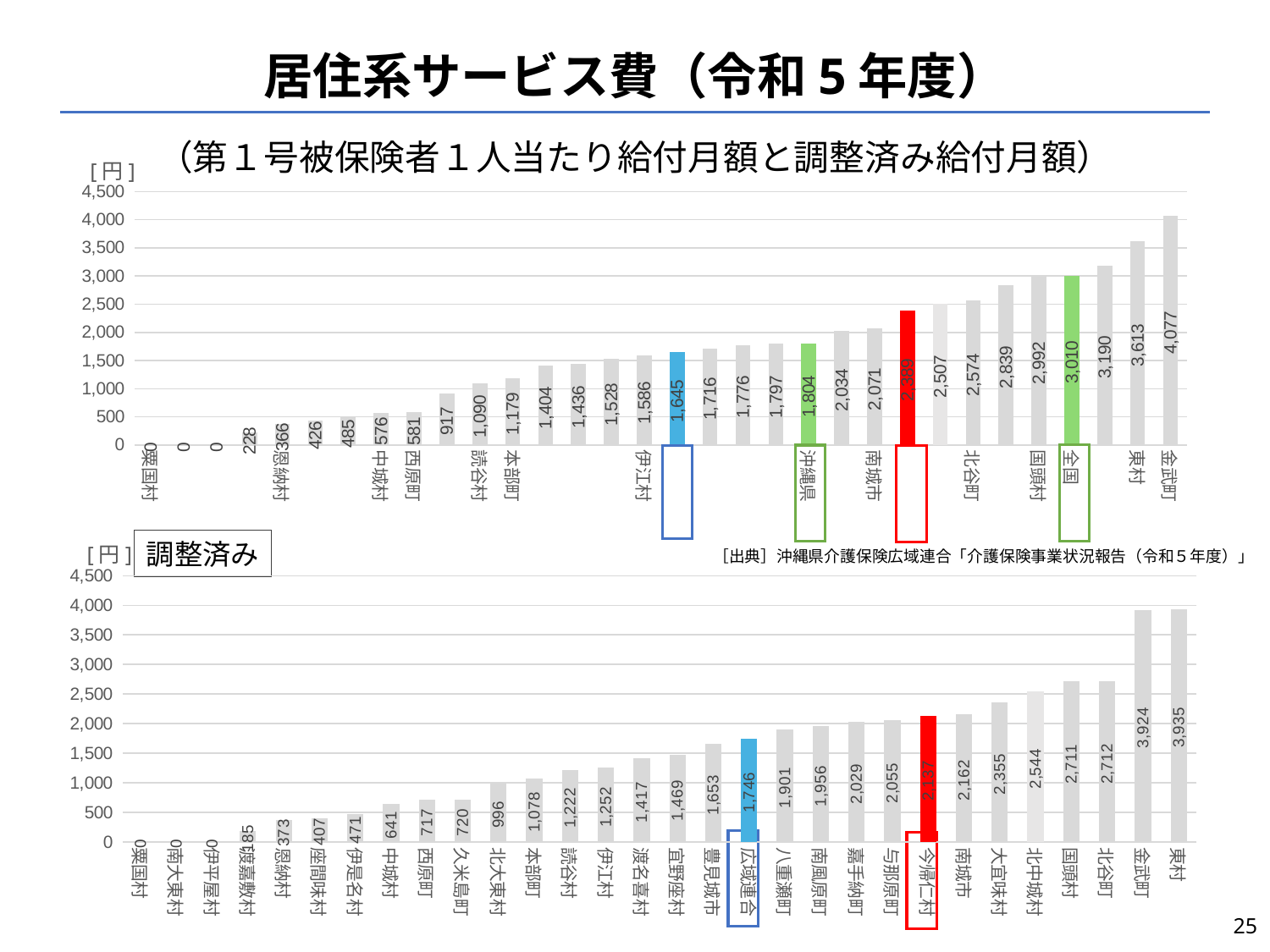
In the top chart, which category has the highest value? 金武町 In the top chart (第1号被保険者1人当たり給付月額), what is the value for 金武町? 4,077 In the top chart, what is the value for 沖縄県? 1,804 In the top chart, what is the difference between 東村 and 国頭村? 621 In the bottom chart (調整済み), which is larger, 北谷町 or 国頭村? 北谷町 In the bottom chart (調整済み), which category has the highest value? 東村 In the bottom chart (調整済み), do the values rise or fall from left to right? rise In the bottom chart (調整済み), what is the value for 今帰仁村? 2,137 What type of chart is the bottom chart (調整済み)? bar chart In the bottom chart (調整済み), what is the value for 広域連合? 1,746 In the bottom chart (調整済み), how many categories are plotted? 30 In the top chart, what is the value for 全国? 3,010